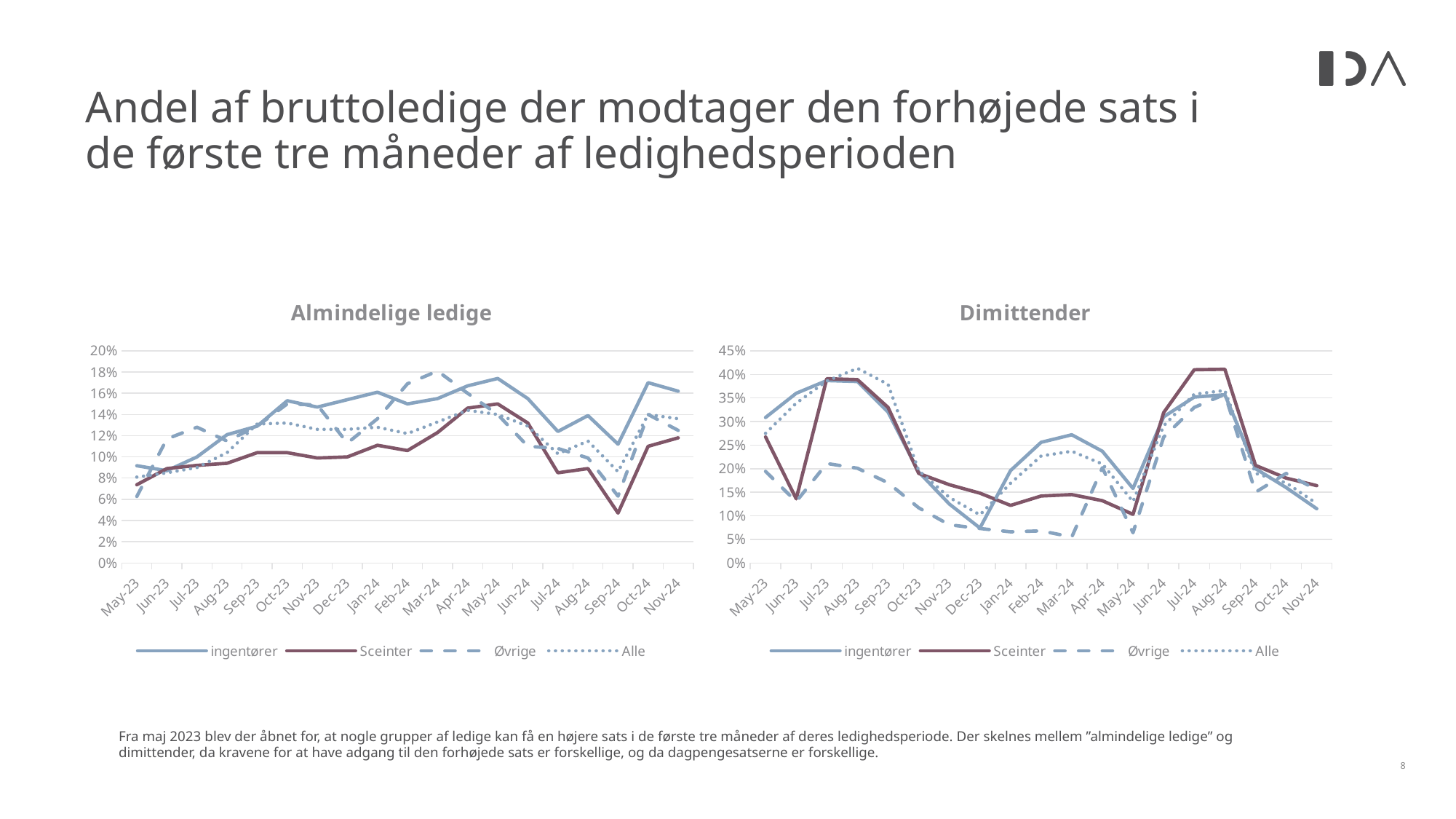
How many series does the legend of the 'Dimittender' chart list? 4 In the 'Almindelige ledige' chart, is the value for Sceinter in Sep-24 greater or less than 6%? less In the 'Almindelige ledige' chart, in which month is the Sceinter series at its lowest? Sep-24 In the 'Dimittender' chart, does the Sceinter series rise or fall from Aug-23 to Dec-23? fall What is the title of the chart on the right side of the slide? Dimittender What kind of chart is the 'Almindelige ledige' chart? line chart In the 'Almindelige ledige' chart, is the value for ingentører in May-24 greater or less than 16%? greater In the 'Dimittender' chart, is the value for ingentører in Dec-23 greater or less than 10%? less In the 'Almindelige ledige' chart, which is larger in Sep-24: ingentører or Sceinter? ingentører How many months are shown on the x axis of the 'Almindelige ledige' chart? 19 In the 'Dimittender' chart, in which month is the ingentører series at its lowest? Dec-23